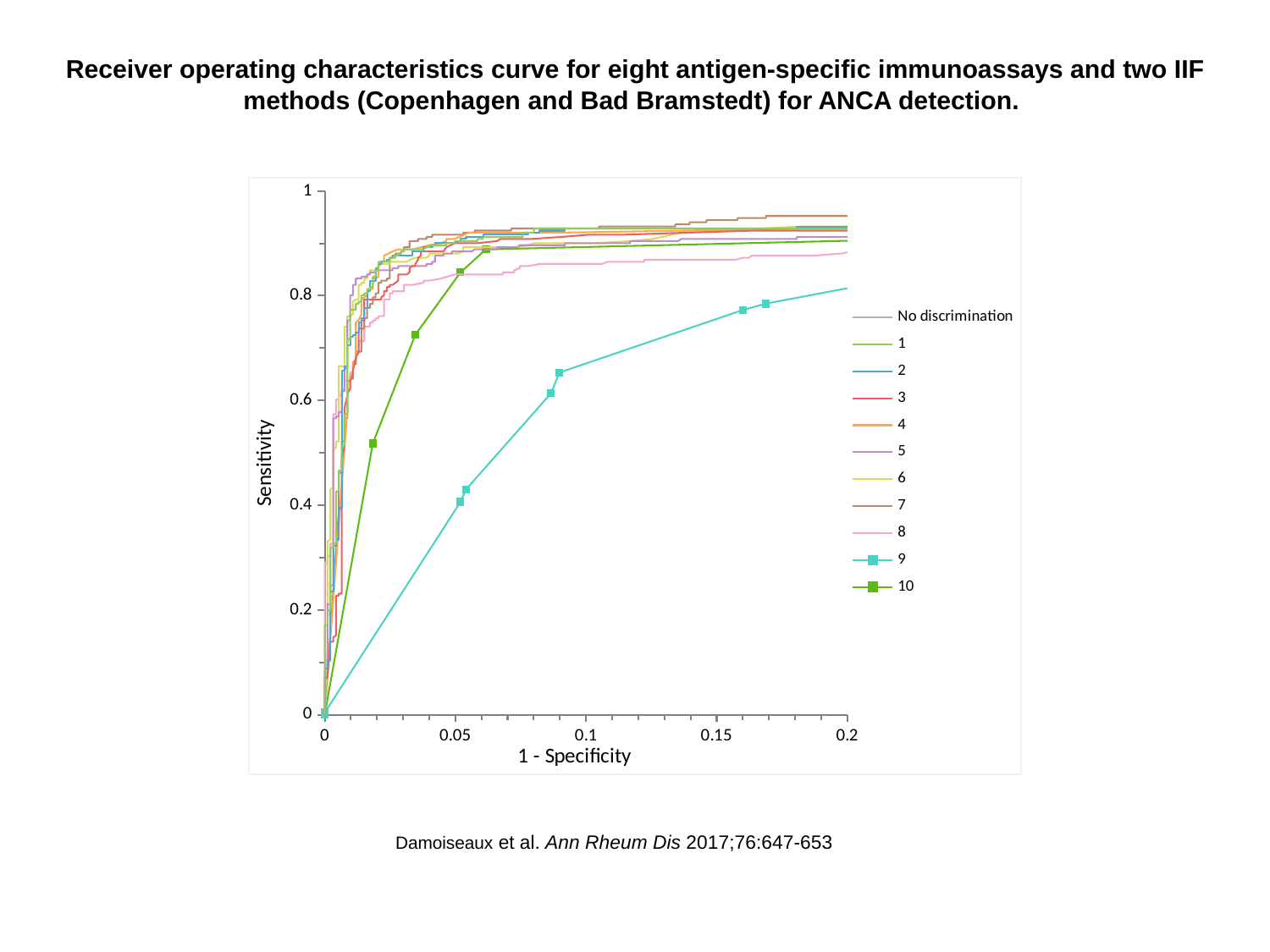
What kind of chart is shown on the slide? line chart Does the sensitivity for series 9 rise or fall as 1 - Specificity increases? rise What is the label of the x axis? 1 - Specificity How many series does the legend list? 11 At 1 - Specificity = 0.2, is the sensitivity for series 9 greater or less than 0.9? less What is the maximum value shown on the x axis? 0.2 At 1 - Specificity = 0.1, which series has the higher sensitivity, series 9 or series 10? 10 At 1 - Specificity = 0.1, is the sensitivity for series 9 greater or less than 0.8? less Which series has the lowest curve across the plotted range? 9 At 1 - Specificity = 0.05, is the sensitivity for series 10 greater or less than 0.6? greater What is the label of the y axis? Sensitivity